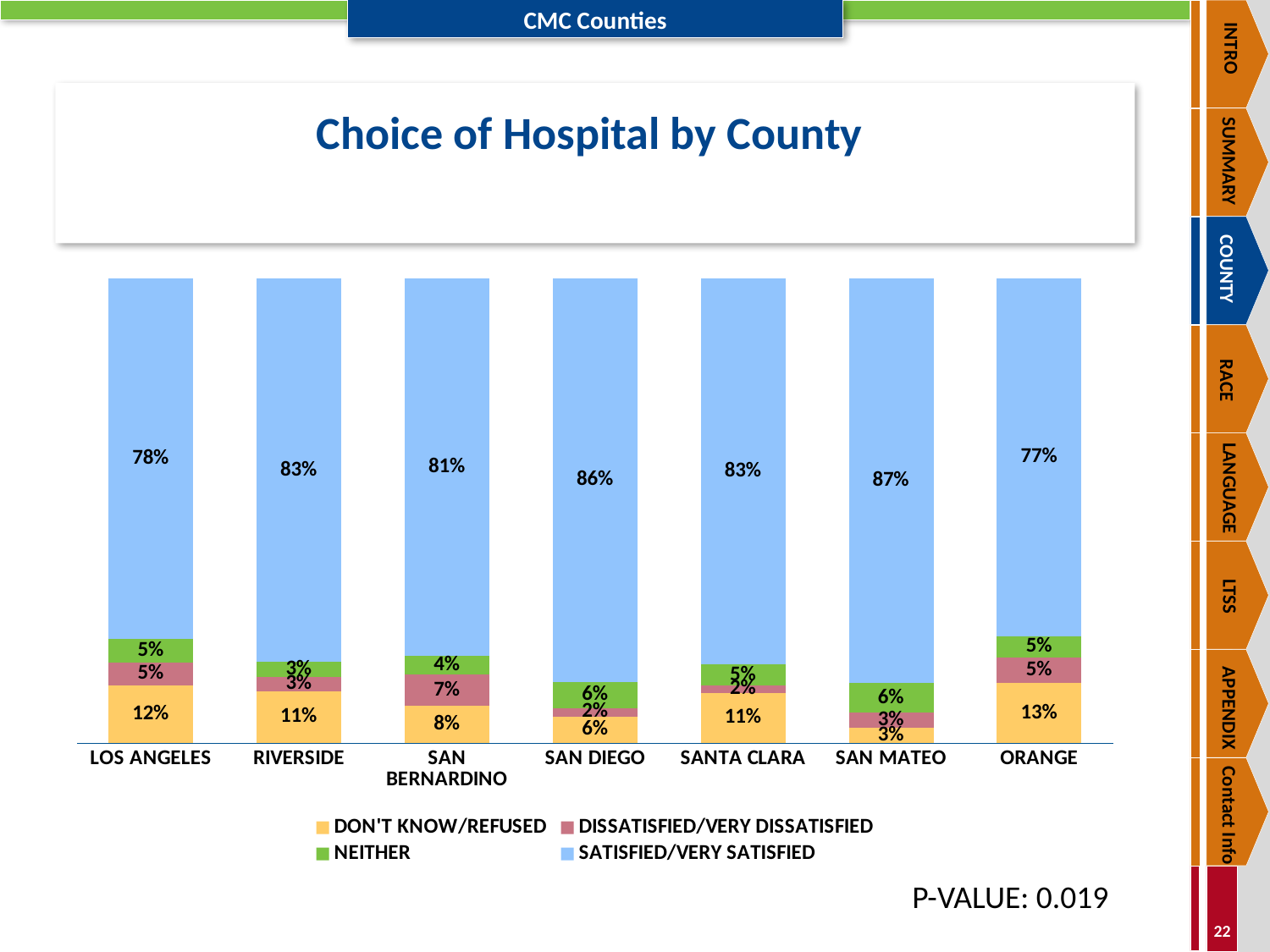
How many counties are shown on the chart? 7 Which county has the lowest Satisfied/Very Satisfied percentage? Orange What p-value is reported below the chart? 0.019 Which county has the highest Don't Know/Refused percentage? Orange What is the difference in Satisfied/Very Satisfied percentage between San Mateo and Orange? 10 percentage points What is the Don't Know/Refused percentage for Orange county? 13% Which county has the highest Satisfied/Very Satisfied percentage? San Mateo Which county has a higher Satisfied/Very Satisfied percentage, Riverside or Los Angeles? Riverside What is the Dissatisfied/Very Dissatisfied percentage for San Bernardino? 7% What type of chart is shown on the slide? Stacked bar chart How many series does the legend list? 4 What percentage of respondents in San Diego were Satisfied/Very Satisfied with their choice of hospital? 86%